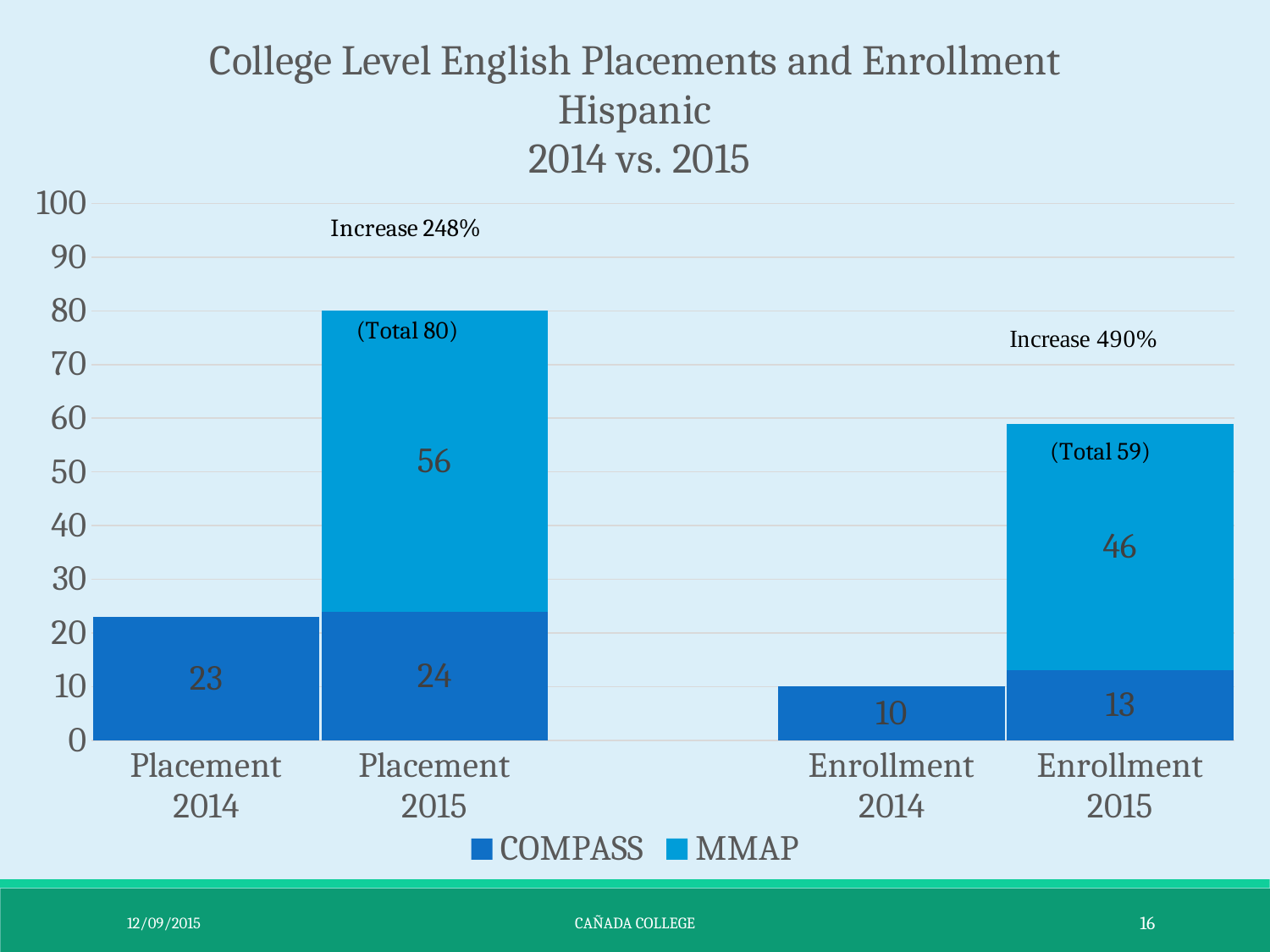
Which is larger, the COMPASS value for Placement 2015 or the COMPASS value for Enrollment 2015? Placement 2015 What is the MMAP value for Enrollment 2015? 46 What percentage increase is noted above the Enrollment 2015 bar? Increase 490% What is the total of the stacked bar for Enrollment 2015? 59 What is the COMPASS value for Enrollment 2014? 10 What is the total of the stacked bar for Placement 2015? 80 What is the MMAP value for Placement 2015? 56 How many series does the legend list? 2 What kind of chart is shown on the slide? Stacked bar chart What is the COMPASS value for Placement 2014? 23 What is the difference between the MMAP values for Placement 2015 and Enrollment 2015? 10 Which category has the lowest COMPASS value? Enrollment 2014